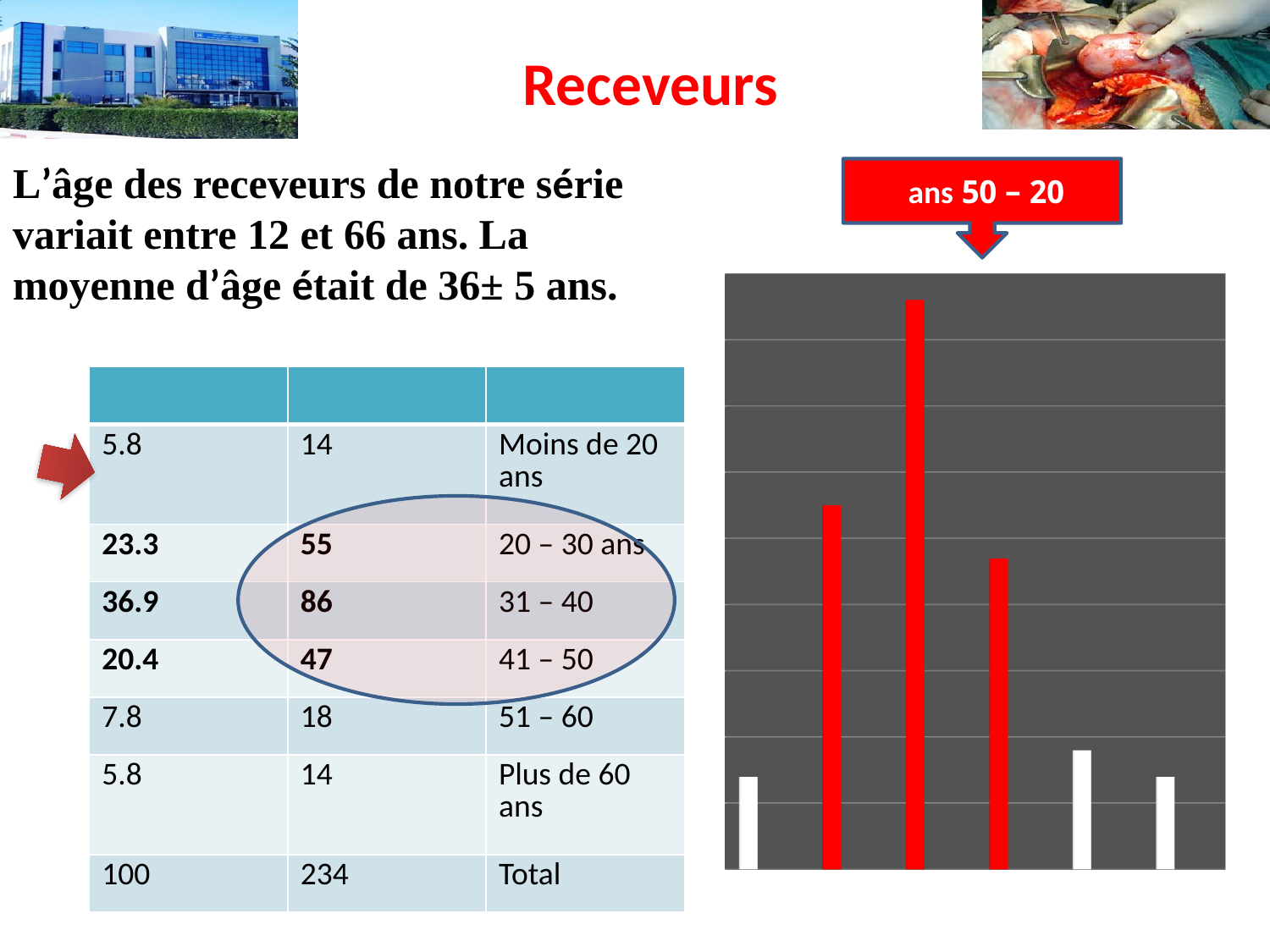
What colour is the tallest bar in the chart on the right? red In the chart on the right, which bar is the tallest, counting from the left? the third bar What kind of chart is shown on the right side of the slide? bar chart How many bars does the chart on the right side of the slide contain? 6 In the chart on the right, which is taller: the second bar from the left or the fourth bar from the left? the second bar How many bars in the chart on the right are coloured red? 3 In the chart on the right, do the bars rise or fall from the third bar to the sixth bar? fall In the chart on the right, which bar is the second tallest, counting from the left? the second bar In the chart on the right, which is taller: the first bar from the left or the fifth bar from the left? the fifth bar